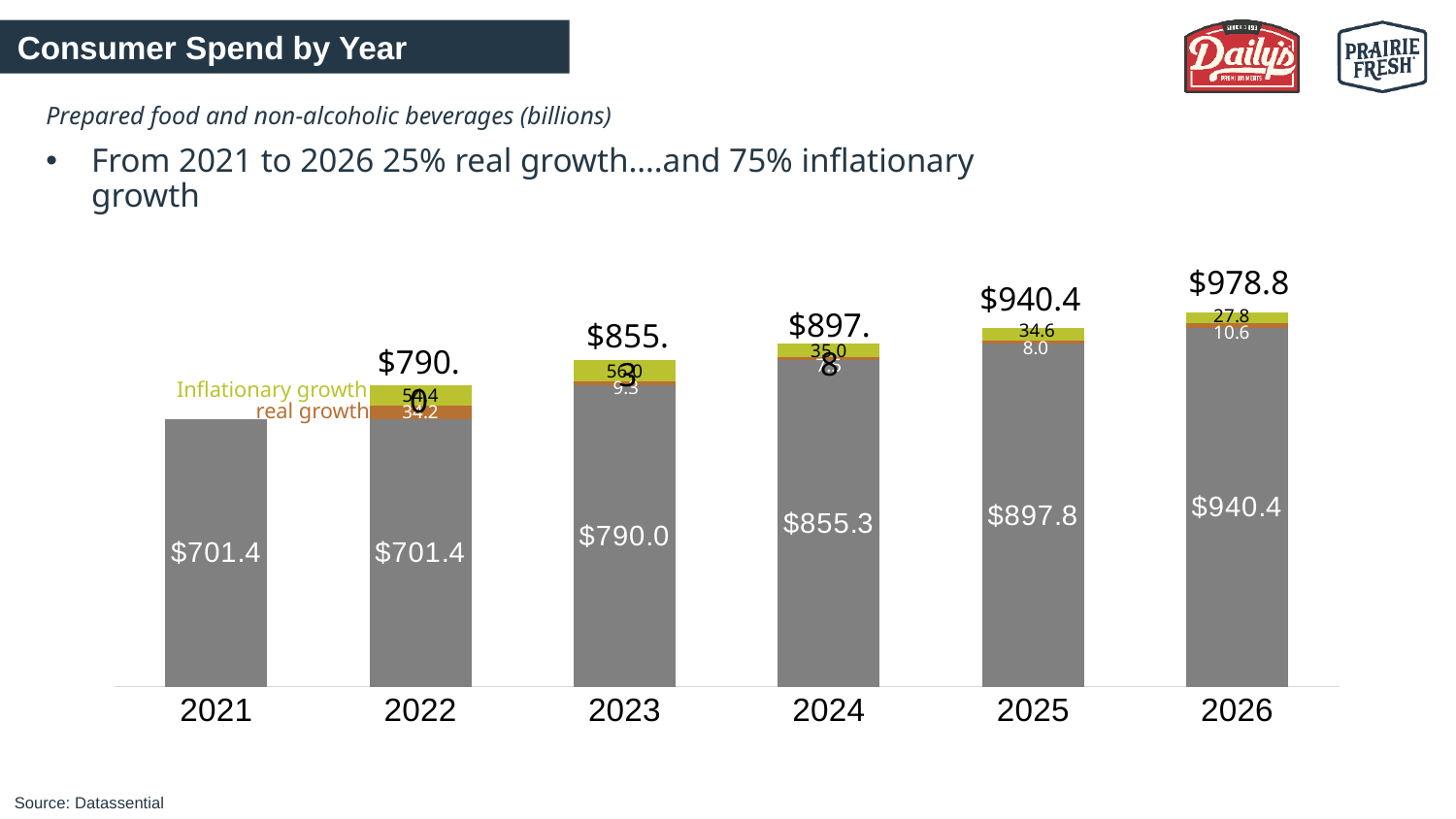
What is the inflationary growth value labeled on the 2026 bar? 27.8 Do the bar totals rise or fall from 2021 to 2026? Rise What is the real growth value labeled on the 2022 bar? 34.2 What kind of chart is shown on the slide? Stacked bar chart How many years are shown on the x axis? 6 What is the real growth value labeled on the 2025 bar? 8.0 What is the value of the gray base segment for 2021? $701.4 What is the value of the gray base segment for 2024? $855.3 What total value is shown above the 2026 bar? $978.8 Which year has the tallest bar? 2026 What is the difference between the total shown above the 2026 bar and the total shown above the 2025 bar? $38.4 What total value is shown above the 2025 bar? $940.4